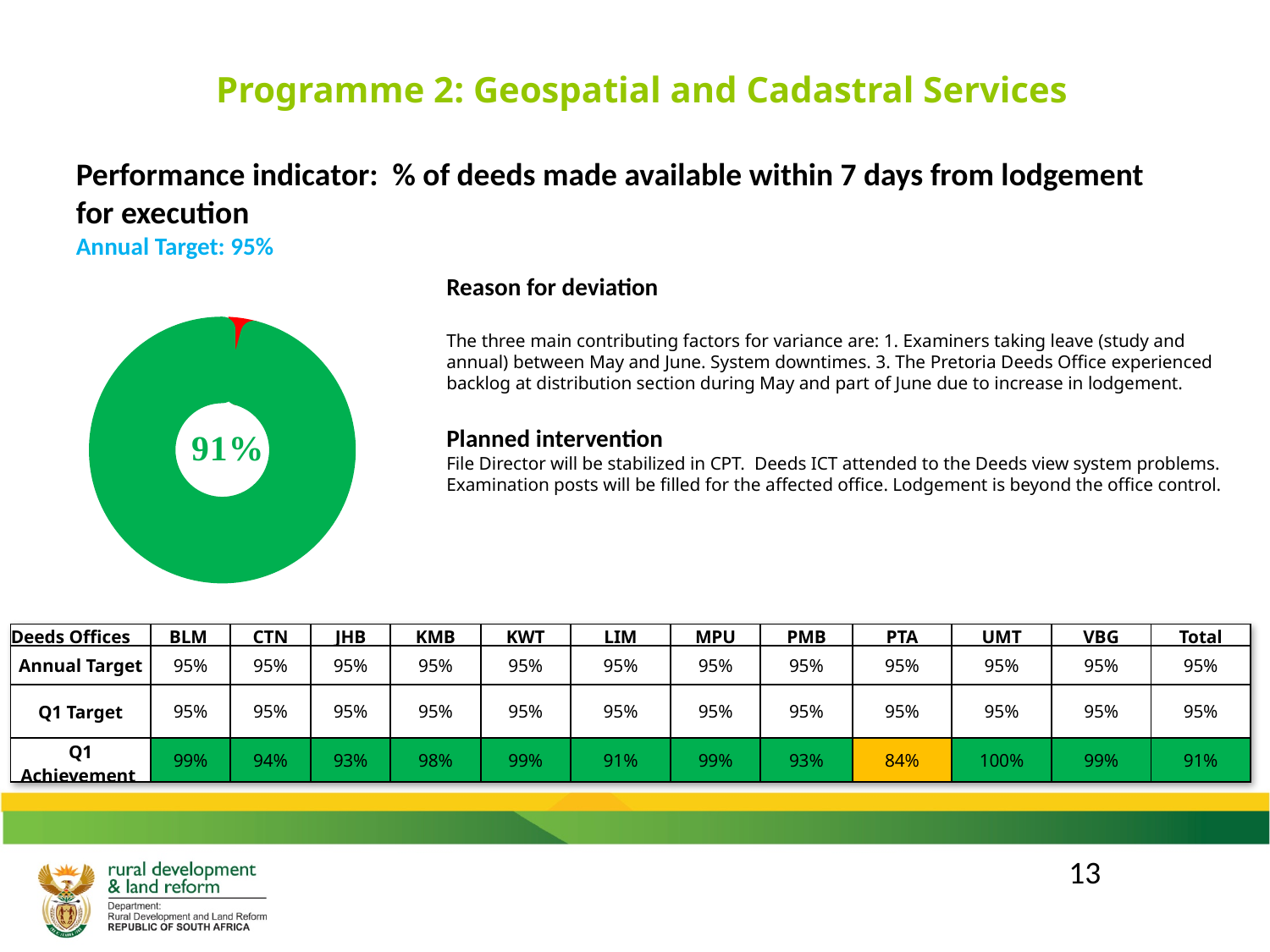
What colour is the small slice of the doughnut chart? red Which slice of the doughnut chart is larger, the green one or the red one? the green one What value is printed in the centre of the doughnut chart? 91% How many slices does the doughnut chart have? 2 Is the value shown in the centre of the doughnut chart greater or less than the annual target of 95% stated on the slide? less What colour is the large slice of the doughnut chart? green What kind of chart is shown on the left of the slide? doughnut chart